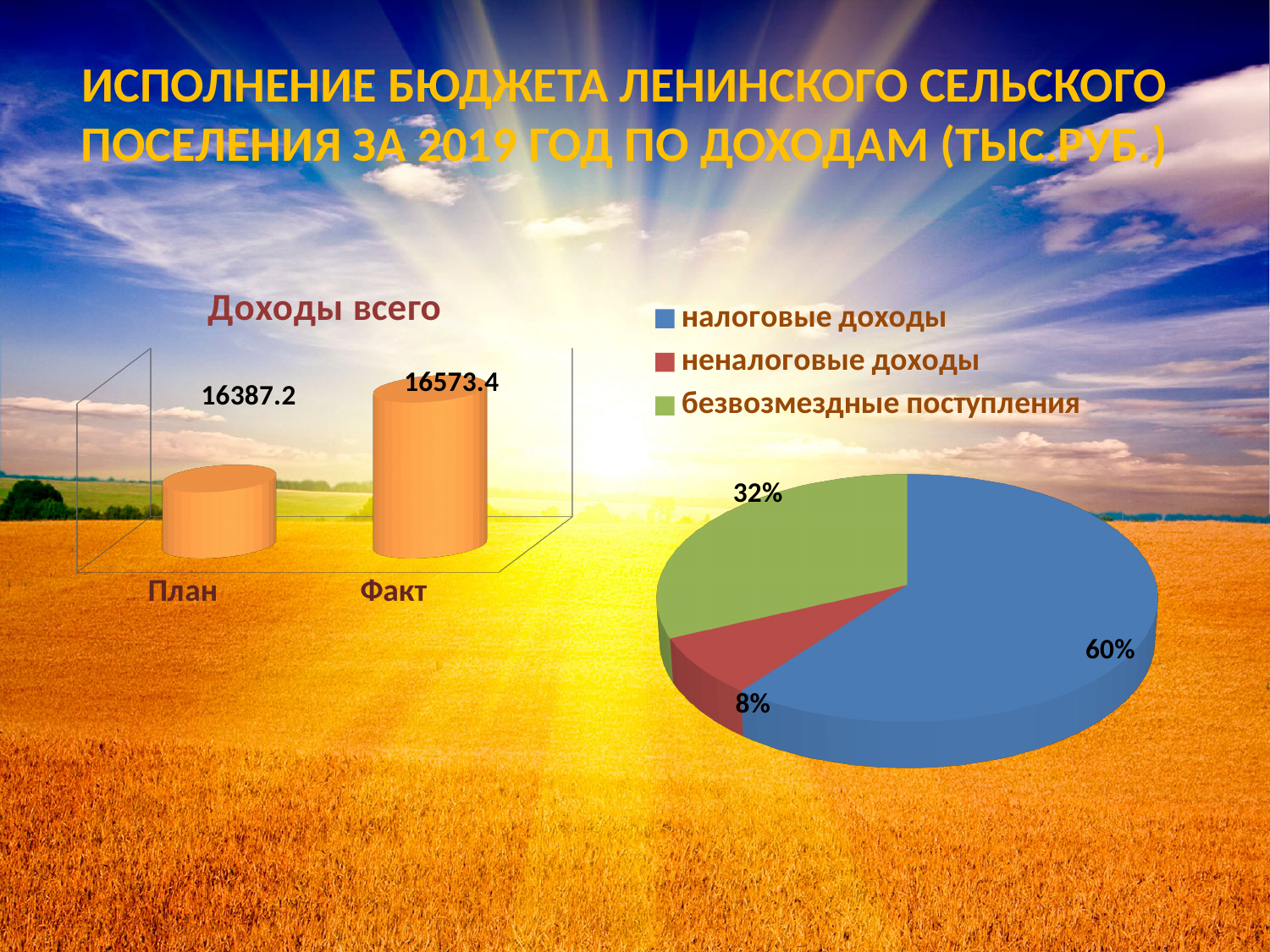
In the 'Доходы всего' chart, what is the difference between Факт and План? 186.2 In the pie chart on the right, what share is безвозмездные поступления? 32% What kind of chart is the 'Доходы всего' chart on the left? Bar chart In the pie chart on the right, what colour is the slice for безвозмездные поступления? Green In the pie chart on the right, what share is налоговые доходы? 60% In the 'Доходы всего' chart, which category has the higher value, План or Факт? Факт In the 'Доходы всего' chart, what is the value for Факт? 16573.4 In the pie chart on the right, which category has the smallest share? неналоговые доходы In the 'Доходы всего' chart, how many categories are shown? 2 In the 'Доходы всего' chart, what is the value for План? 16387.2 In the pie chart on the right, what share is неналоговые доходы? 8% In the pie chart on the right, how many entries does the legend list? 3